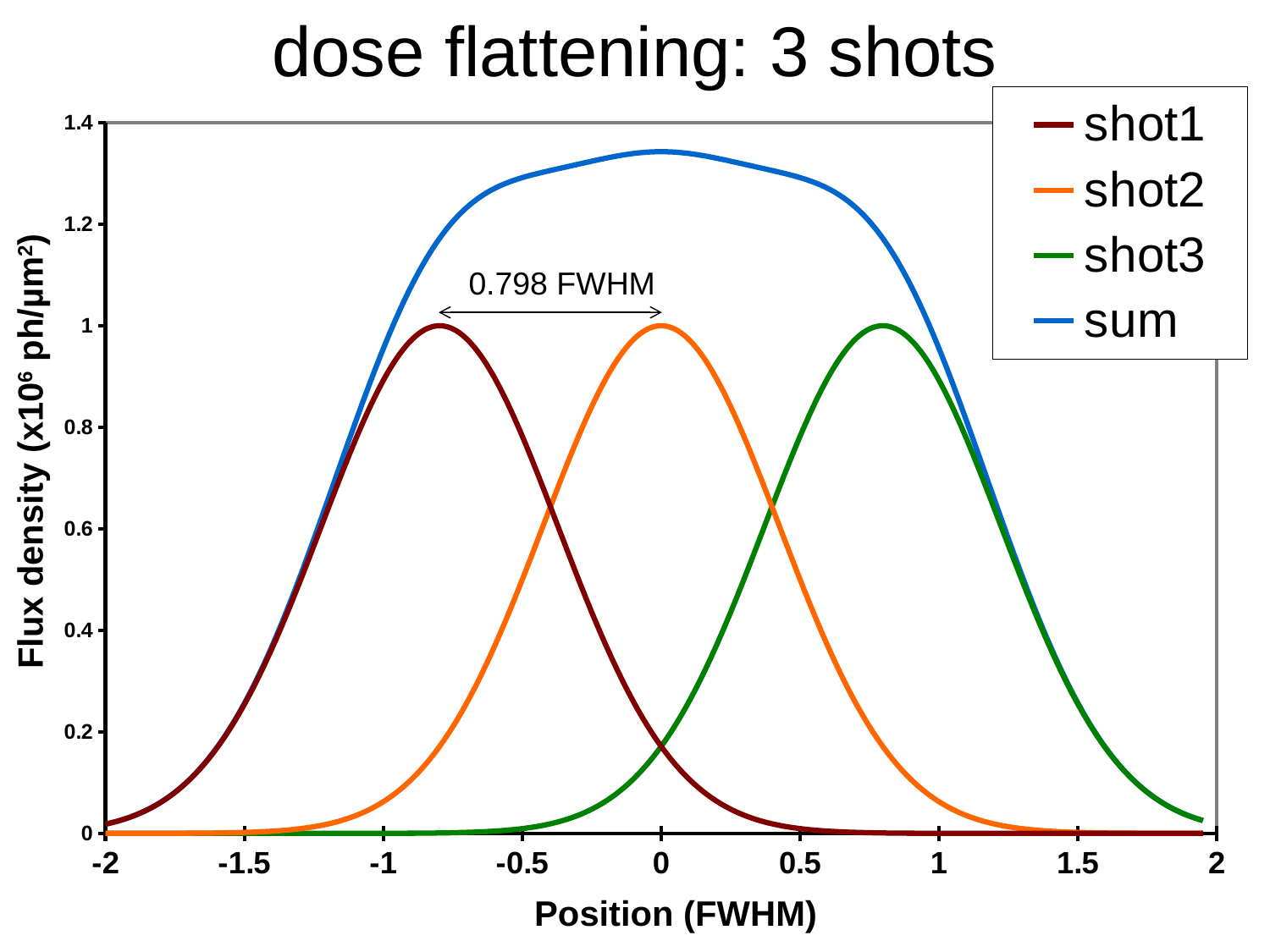
What is the label of the x axis? Position (FWHM) What kind of chart is shown on the slide? line chart What is the title of the chart? dose flattening: 3 shots Which series is drawn in blue? sum Is the peak value of the sum series greater or less than 1.4? less At position 0, which is larger: shot2 or shot1? shot2 What is the label of the y axis? Flux density (x10⁶ ph/μm²) Does the shot3 series rise or fall as position increases from 1 to 2? fall How many series does the legend list? 4 Is the peak value of the sum series greater or less than 1.2? greater Which series reaches the highest value on the chart? sum What spacing between shot peaks is annotated on the chart? 0.798 FWHM